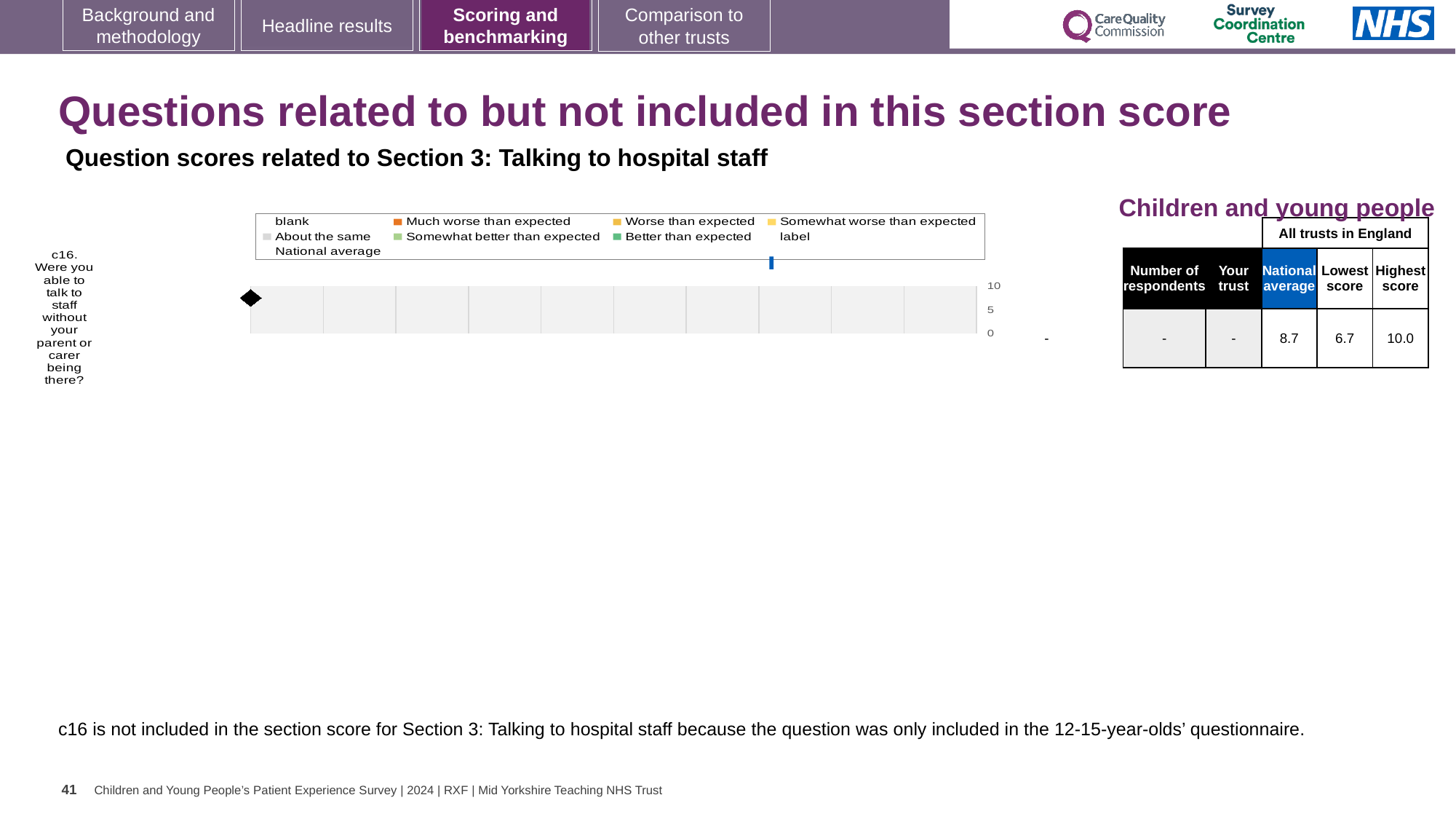
In the table next to the chart, what is shown as the Your trust score for c16? - What is the highest tick value shown on the chart's axis? 10 Which question number is plotted in the chart? c16 What is the difference between the Highest score and the Lowest score for c16 in the table? 3.3 In the table next to the chart, what is the Highest score for c16 across all trusts in England? 10.0 Which is larger for c16 in the table: the National average or the Lowest score? National average Is the National average score for c16 greater or less than 5? greater In the table next to the chart, what is the Lowest score for c16 across all trusts in England? 6.7 In the table next to the chart, what is the National average score for c16? 8.7 How many survey questions are plotted in the chart? 1 What kind of chart is shown for question c16? Bar chart How many entries does the chart legend list? 9